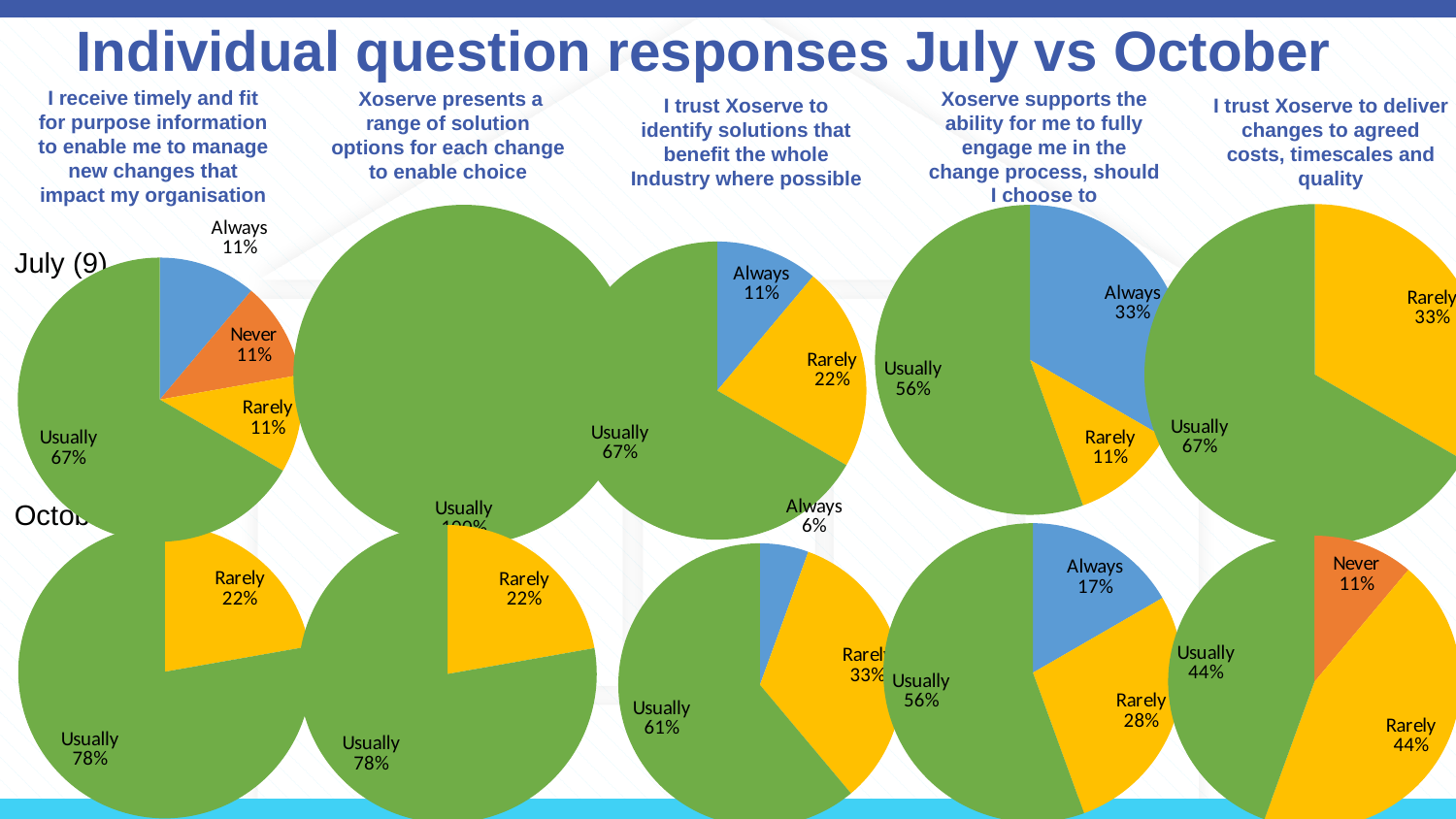
In the October pie chart for 'Xoserve presents a range of solution options for each change to enable choice', how many slices are shown? 2 In the July pie chart for 'Xoserve supports the ability for me to fully engage me in the change process, should I choose to', which response has the largest share? Usually What type of charts are shown on the slide? Pie charts In the July pie chart for 'I trust Xoserve to identify solutions that benefit the whole Industry where possible', what share is 'Rarely'? 22% In the July pie chart for 'I receive timely and fit for purpose information to enable me to manage new changes that impact my organisation', what share is 'Usually'? 67% In the October pie chart for 'I trust Xoserve to identify solutions that benefit the whole Industry where possible', what share is 'Always'? 6% What is the difference between the 'Usually' share in July (67%) and October (78%) for 'I receive timely and fit for purpose information to enable me to manage new changes that impact my organisation'? 11% In the October pie chart for 'I receive timely and fit for purpose information to enable me to manage new changes that impact my organisation', what share is 'Rarely'? 22% In the July pie chart for 'I trust Xoserve to deliver changes to agreed costs, timescales and quality', what share is 'Rarely'? 33% In the October pie chart for 'I trust Xoserve to identify solutions that benefit the whole Industry where possible', which is larger, 'Rarely' or 'Always'? Rarely In the October pie chart for 'I trust Xoserve to deliver changes to agreed costs, timescales and quality', what share is 'Never'? 11% In the October pie chart for 'Xoserve supports the ability for me to fully engage me in the change process, should I choose to', what share is 'Rarely'? 28%